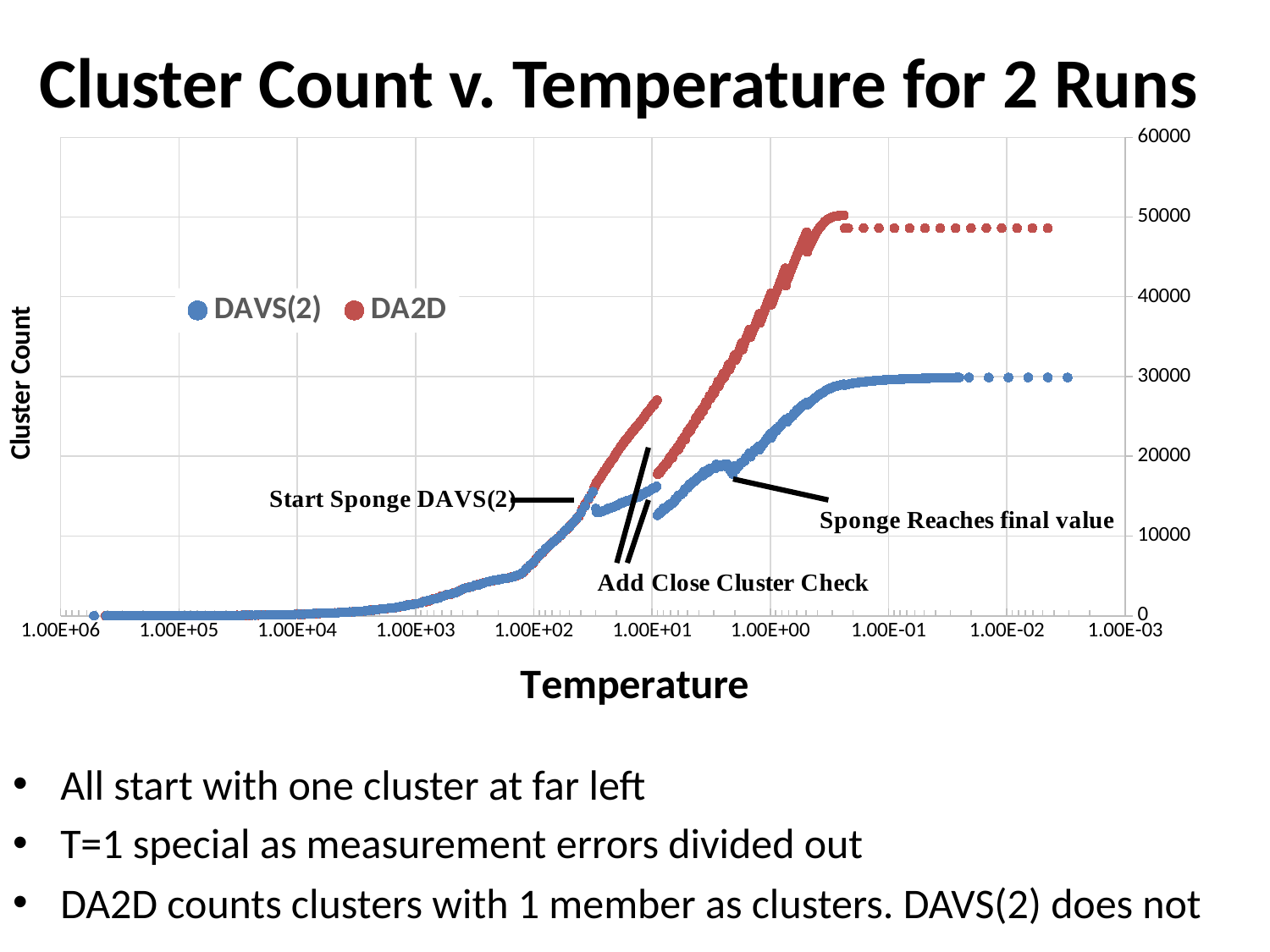
What is the title of the chart? Cluster Count v. Temperature for 2 Runs Which series has the lower cluster count at the far right of the chart? DAVS(2) Is the final plateau value of the DAVS(2) series greater or less than 20000? greater What kind of chart is shown on the slide? Scatter chart Is the final plateau value of the DAVS(2) series greater or less than 40000? less What are the two series named in the legend? DAVS(2) and DA2D Is the DA2D series' highest value greater or less than 60000? less How many series does the legend list? 2 Do the cluster counts generally rise or fall moving from left to right along the temperature axis? rise What is the maximum value shown on the vertical Cluster Count axis? 60000 Which series reaches the higher final cluster count at the right end of the chart, DAVS(2) or DA2D? DA2D